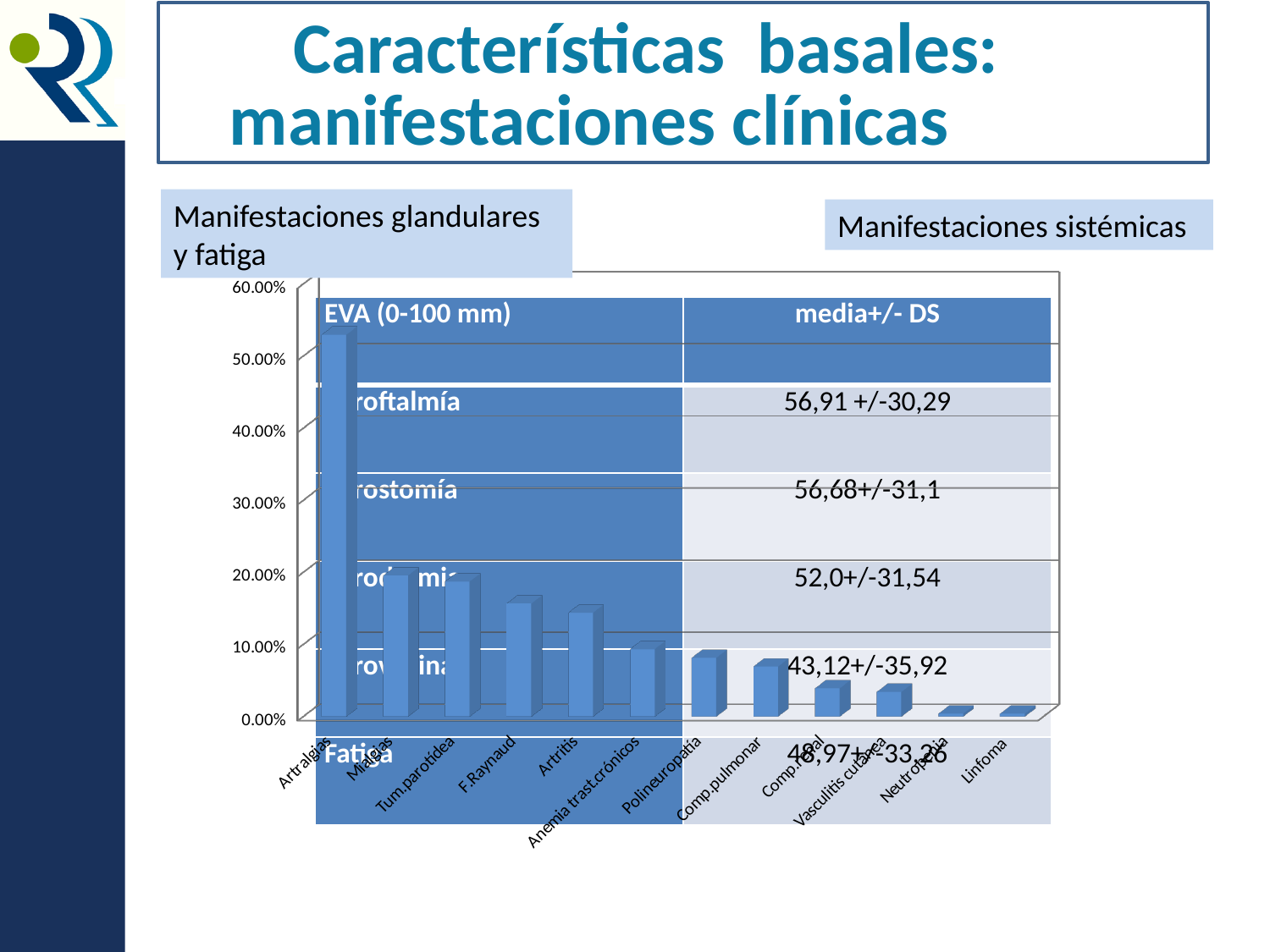
Is the value for Mialgias greater or less than 30.00%? less Is the value for F.Raynaud greater or less than 10.00%? greater Which is larger, the value for Artritis or the value for Comp.renal? Artritis Which is larger, the value for Artralgias or the value for Mialgias? Artralgias How many categories are plotted along the x axis of the chart? 12 Is the value for Linfoma greater or less than 10.00%? less Do the bar values generally rise or fall from left to right along the x axis? Fall What is the highest tick value shown on the chart's vertical axis? 60.00% What kind of chart is shown on the slide? Bar chart Which category has the highest value in the chart? Artralgias